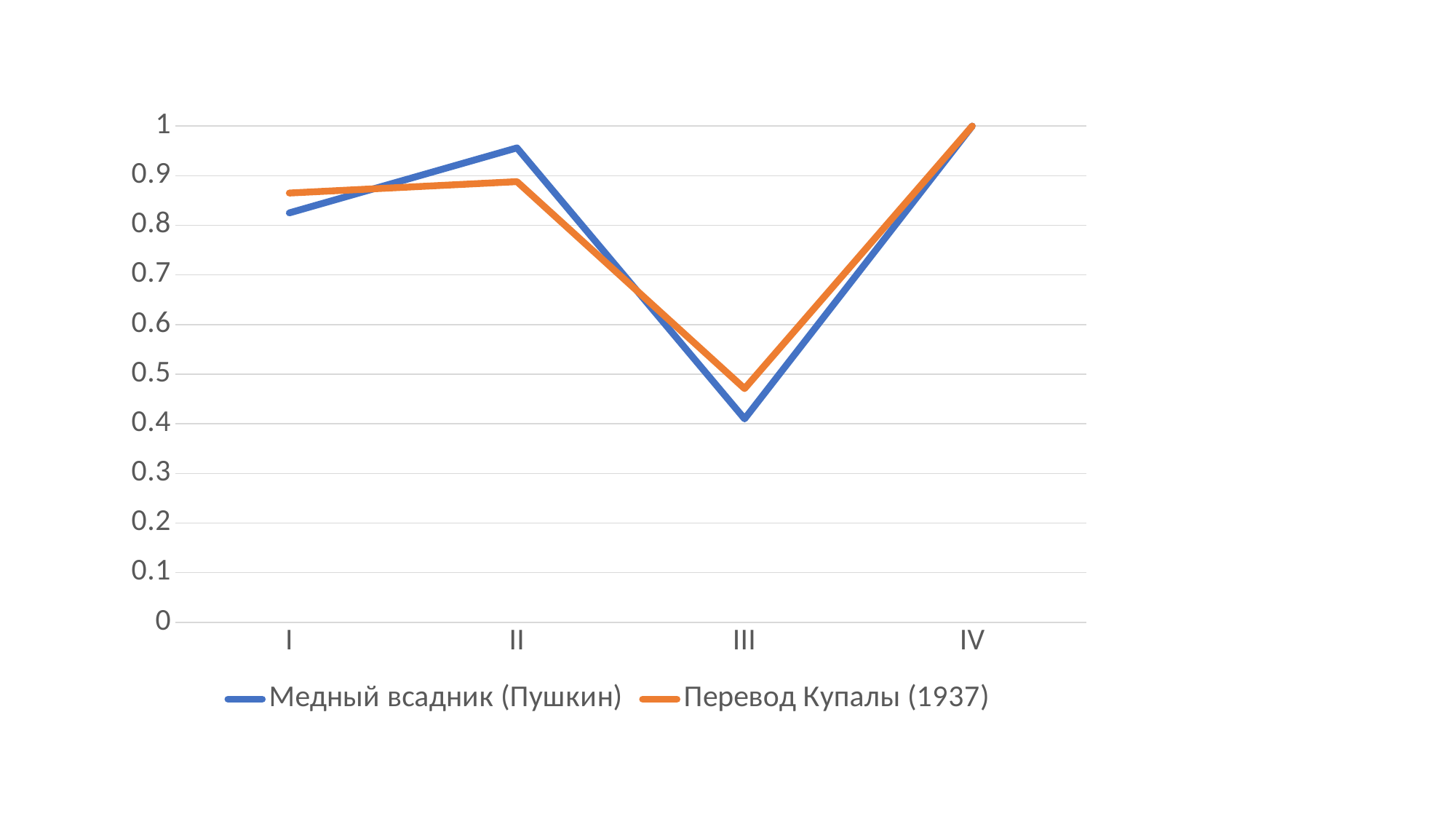
Is the value for Медный всадник (Пушкин) at III greater or less than 0.5? less How many series does the legend list? 2 What kind of chart is shown on the slide? line chart At III, which series has the higher value, Медный всадник (Пушкин) or Перевод Купалы (1937)? Перевод Купалы (1937) At which category is the value for Медный всадник (Пушкин) lowest? III What is the value of Перевод Купалы (1937) at IV? 1 At II, which series has the higher value, Медный всадник (Пушкин) or Перевод Купалы (1937)? Медный всадник (Пушкин) How many categories are shown on the x axis? 4 At which category is the value for Перевод Купалы (1937) highest? IV Is the value for Перевод Купалы (1937) at III greater or less than 0.6? less What is the value of Медный всадник (Пушкин) at IV? 1 Is the value for Медный всадник (Пушкин) at II greater or less than 0.9? greater